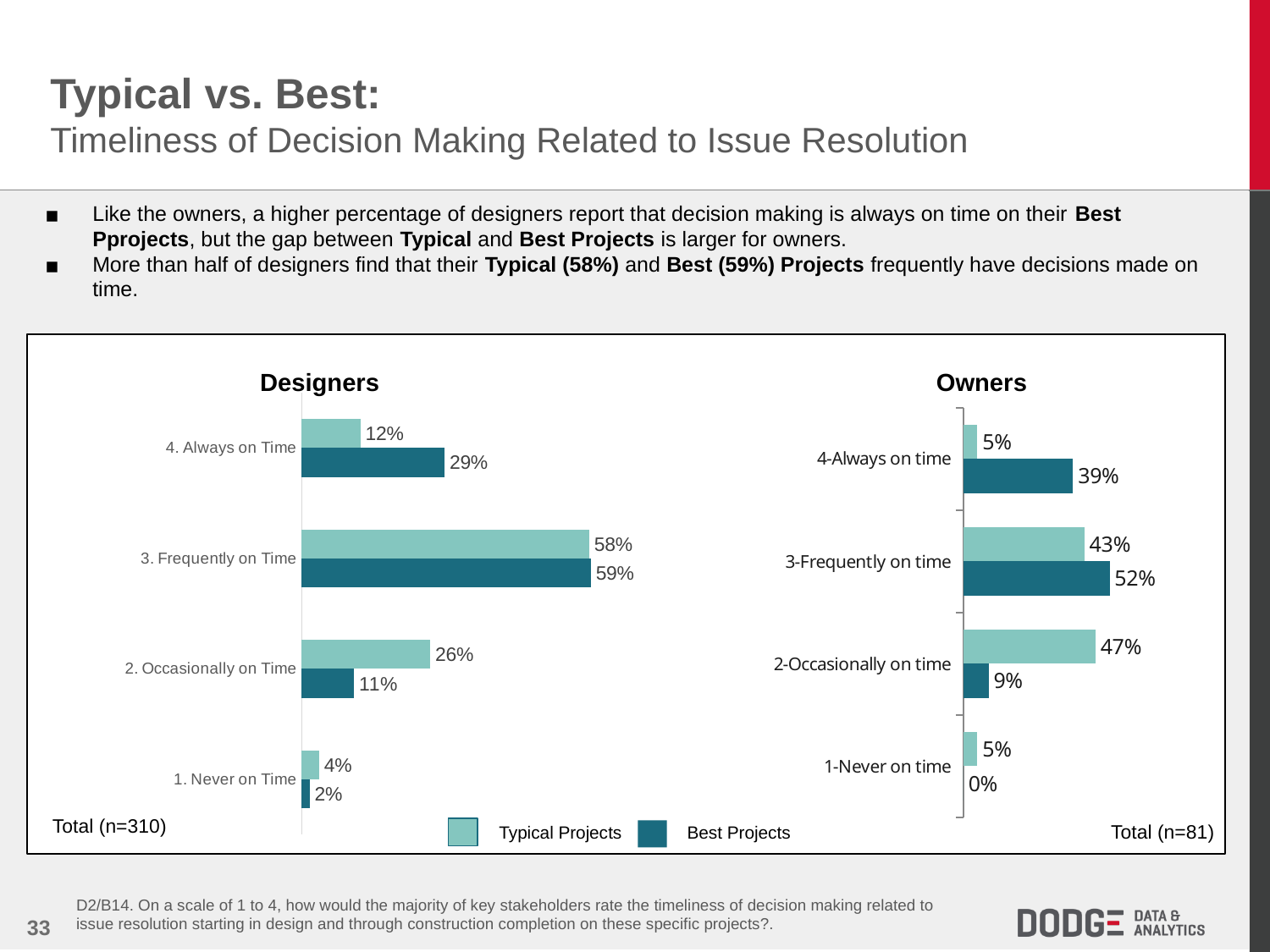
In the Owners chart, what is the difference between Best Projects and Typical Projects for '4-Always on time'? 34% What is the sample size (n) shown for the Owners chart? 81 In the Owners chart, what percentage of Best Projects are rated '4-Always on time'? 39% In the Owners chart, which is larger for '3-Frequently on time': Typical Projects or Best Projects? Best Projects How many categories are shown in the Designers chart? 4 In the Owners chart, which category has the highest value for Typical Projects? 2-Occasionally on time What type of chart is the Owners chart? Bar chart How many series does the legend list? 2 In the Designers chart, what percentage of Typical Projects are rated '3. Frequently on Time'? 58% In the Designers chart, which category has the lowest value for Best Projects? 1. Never on Time In the Designers chart, what is the value for Best Projects in the '1. Never on Time' category? 2% In the Designers chart, what is the difference between Typical Projects and Best Projects for '2. Occasionally on Time'? 15%